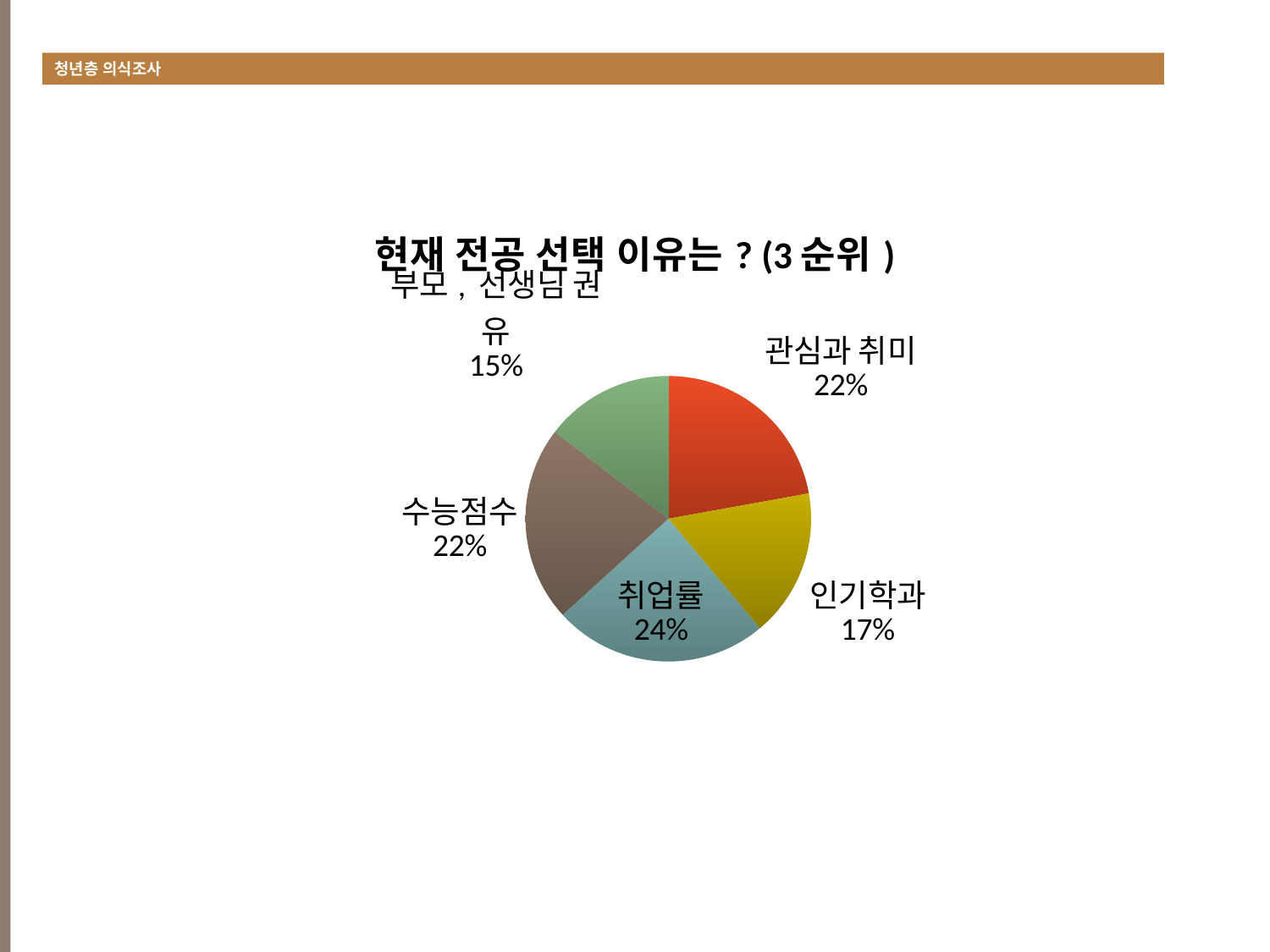
Which category has the smallest slice of the pie? 부모, 선생님 권유 What is the value shown for 인기학과? 17% What percentage is shown for 부모, 선생님 권유? 15% What percentage is shown for 관심과 취미? 22% Which is larger, the slice for 취업률 or the slice for 인기학과? 취업률 Which category has the largest slice of the pie? 취업률 What kind of chart is shown on the slide? pie chart What share of the pie does 취업률 account for? 24% How many categories are shown in the pie chart? 5 What is the difference in percentage points between 수능점수 and 부모, 선생님 권유? 7 What is the difference in percentage points between 취업률 and 인기학과? 7 What is the title of the chart? 현재 전공 선택 이유는 ? (3 순위 )